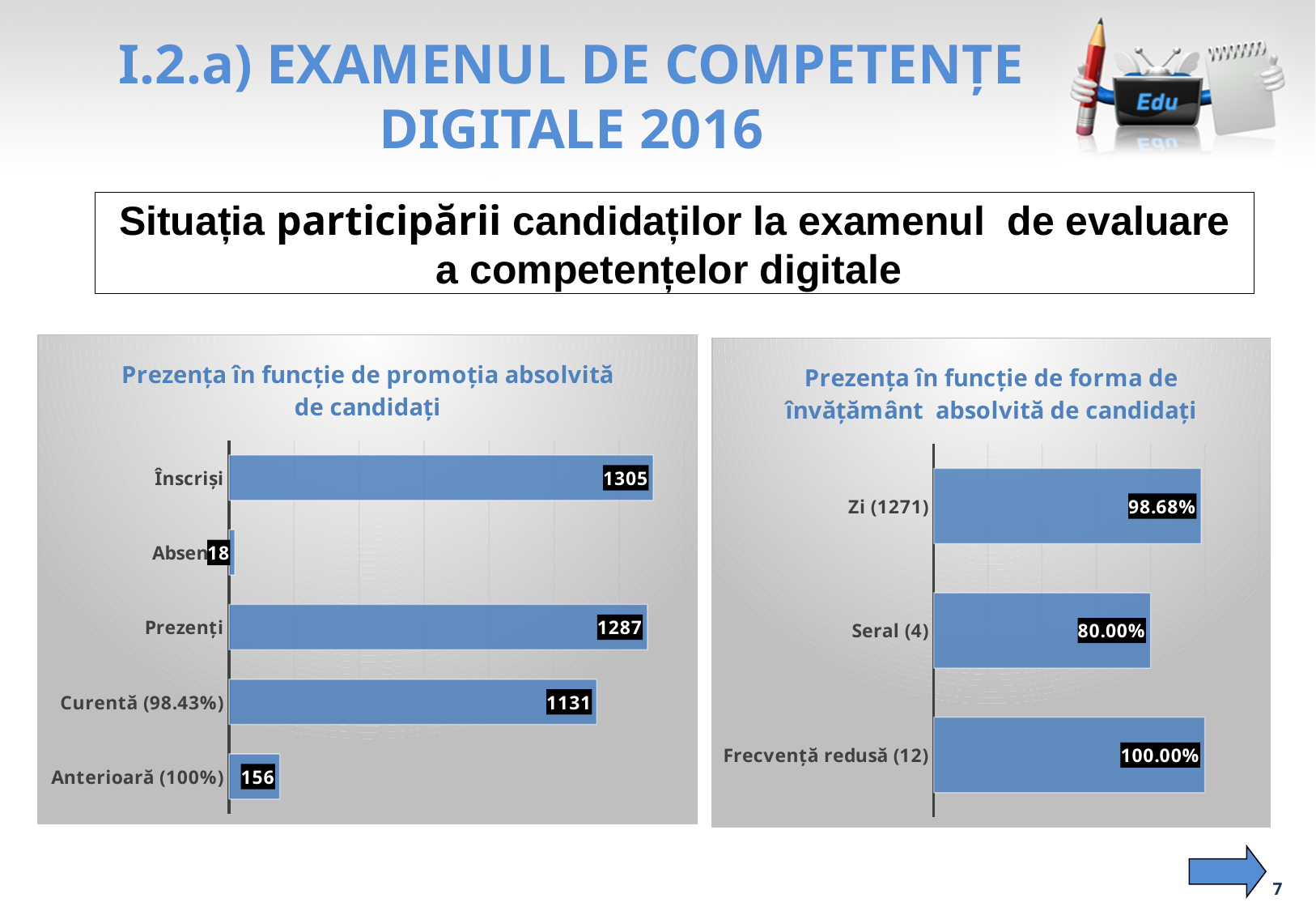
In the chart 'Prezența în funcție de promoția absolvită de candidați', what is the value for Curentă (98.43%)? 1131 In the chart 'Prezența în funcție de promoția absolvită de candidați', how many categories are shown? 5 In the chart 'Prezența în funcție de promoția absolvită de candidați', what is the value for Anterioară (100%)? 156 In the chart 'Prezența în funcție de forma de învățământ absolvită de candidați', what is the value for Seral (4)? 80.00% In the chart 'Prezența în funcție de promoția absolvită de candidați', which category has the highest value? Înscriși In the chart 'Prezența în funcție de forma de învățământ absolvită de candidați', which category has the lowest value? Seral (4) In the chart 'Prezența în funcție de promoția absolvită de candidați', what is the value for Înscriși? 1305 In the chart 'Prezența în funcție de promoția absolvită de candidați', what is the value for Prezenți? 1287 What type of chart is the one on the right side of the slide? Bar chart In the chart 'Prezența în funcție de forma de învățământ absolvită de candidați', what is the difference between Frecvență redusă (12) and Seral (4)? 20.00% In the chart 'Prezența în funcție de forma de învățământ absolvită de candidați', what is the value for Zi (1271)? 98.68% In the chart 'Prezența în funcție de promoția absolvită de candidați', what is the difference between Înscriși and Prezenți? 18